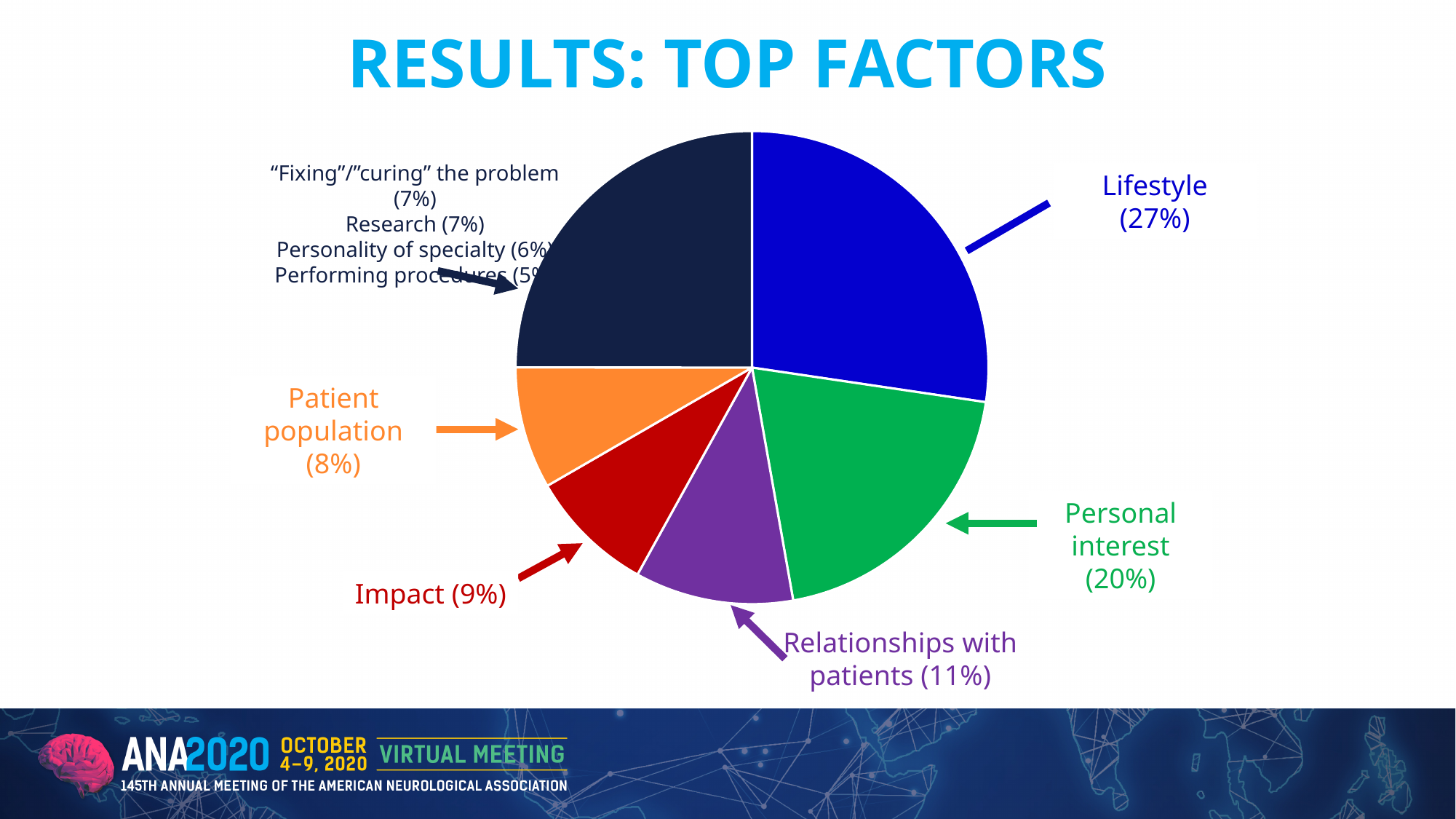
What percentage is shown for Relationships with patients? 11% What percentage is shown for Impact? 9% What percentage is shown for Research? 7% Which individually labelled factor has the largest share of the pie? Lifestyle Which is larger, the share for Impact or the share for Patient population? Impact What percentage is shown for Lifestyle? 27% What is the difference in percentage points between Lifestyle and Personal interest? 7 What type of chart is shown on the slide? pie chart What percentage is shown for Personal interest? 20% What percentage is shown for Patient population? 8% What is the title of the slide? RESULTS: TOP FACTORS Which factor has the smallest percentage listed on the slide? Performing procedures